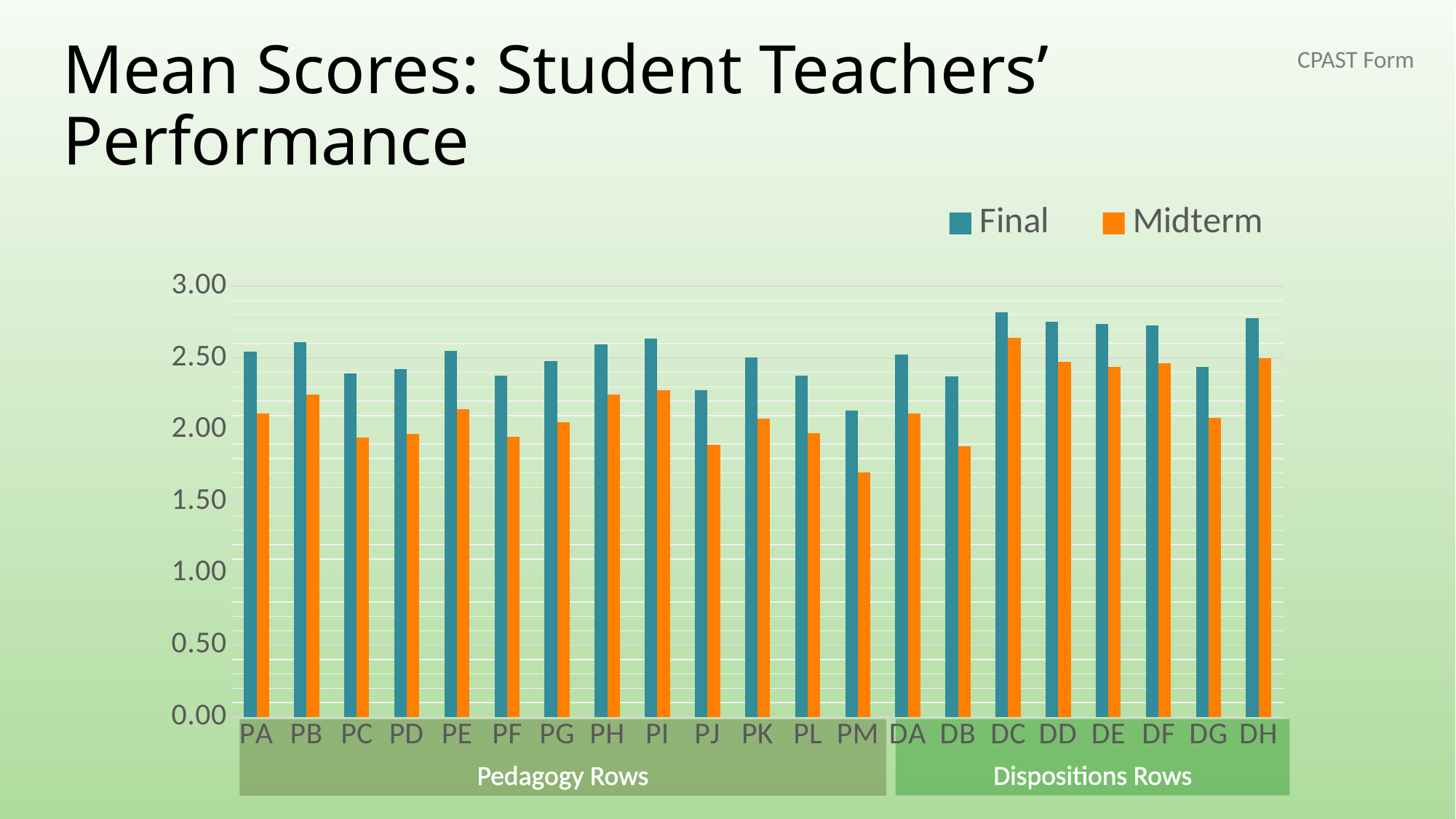
What kind of chart is shown on the slide? bar chart How many series does the legend list? 2 Which category has the lowest Final score? PM How many categories are shown on the x axis? 21 Is the Final value for DC greater or less than 2.50? greater Which category has the lowest Midterm score? PM For PA, which is larger, the Final score or the Midterm score? Final Which category has the highest Midterm score? DC Is the Midterm value for PM greater or less than 2.00? less Is the Final value for PJ greater or less than 2.50? less Which colour represents the Midterm series in the legend? orange